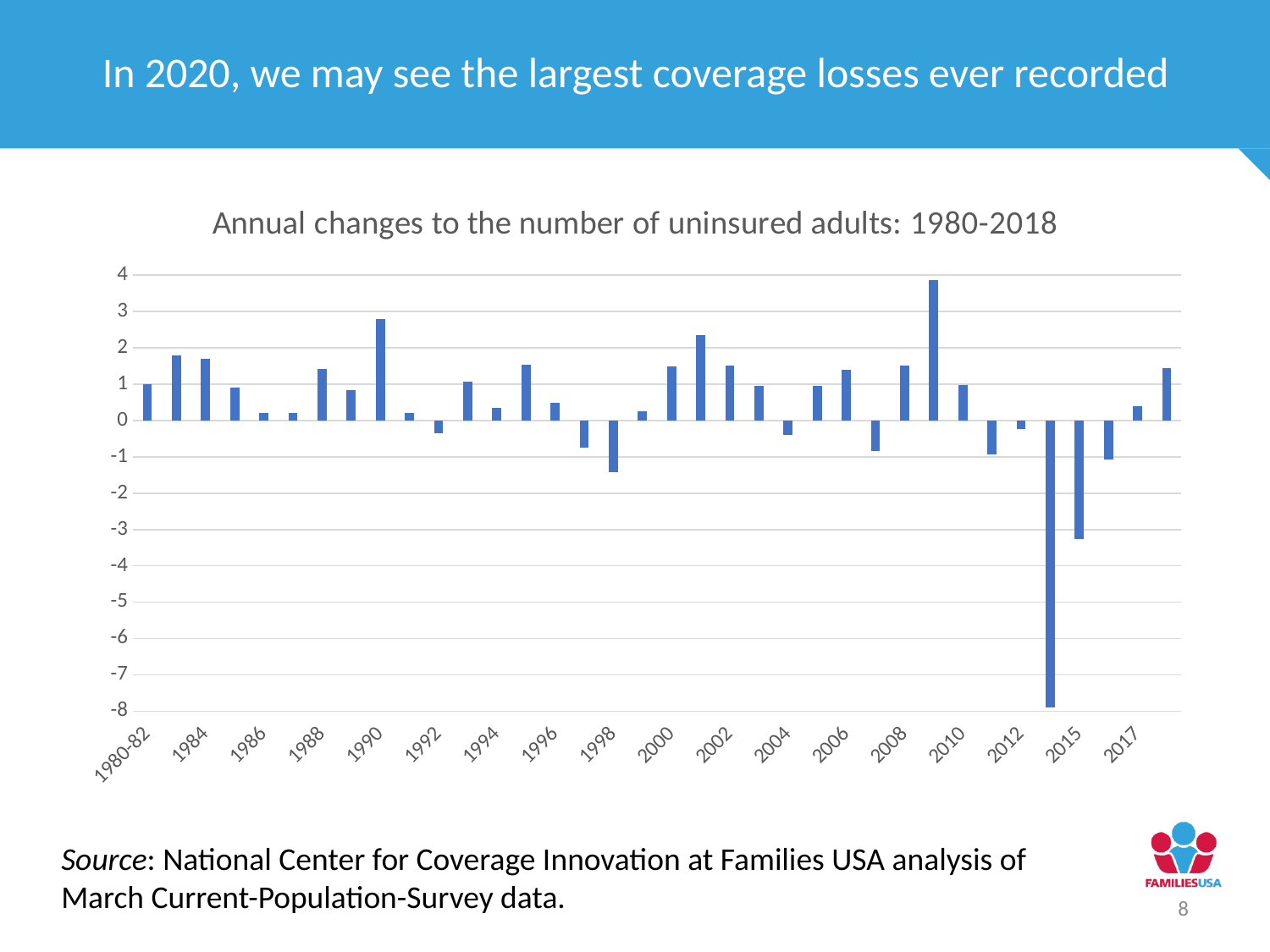
Is the value for 2004 greater or less than 0? less Which has the larger value, 2015 or 2017? 2017 Is the value for 2015 greater or less than -2? less Is the value for 1984 greater or less than 1? greater What is the lowest value shown on the vertical axis? -8 What is the title of the chart? Annual changes to the number of uninsured adults: 1980-2018 What kind of chart is shown on the slide? bar chart Which has the larger value, 1990 or 1986? 1990